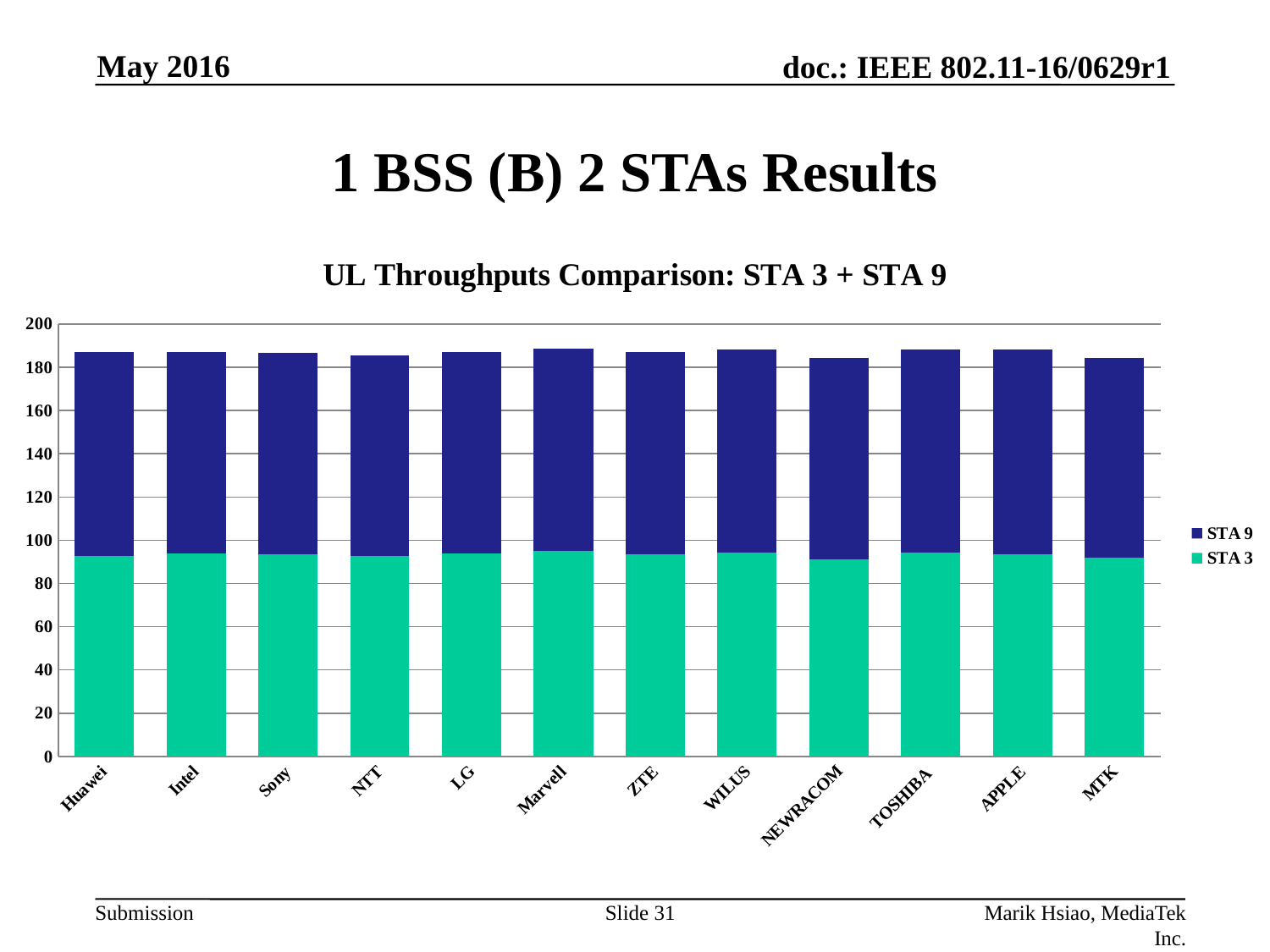
How many categories (companies) are shown on the x axis? 12 Is the STA 3 value for NEWRACOM greater or less than 80? greater Is the total stacked value for MTK greater or less than 200? less Is the STA 3 value for TOSHIBA greater or less than 60? greater What is the title of the chart? UL Throughputs Comparison: STA 3 + STA 9 How many series does the legend list? 2 Which series is shown in green? STA 3 What kind of chart is shown on the slide? stacked bar chart